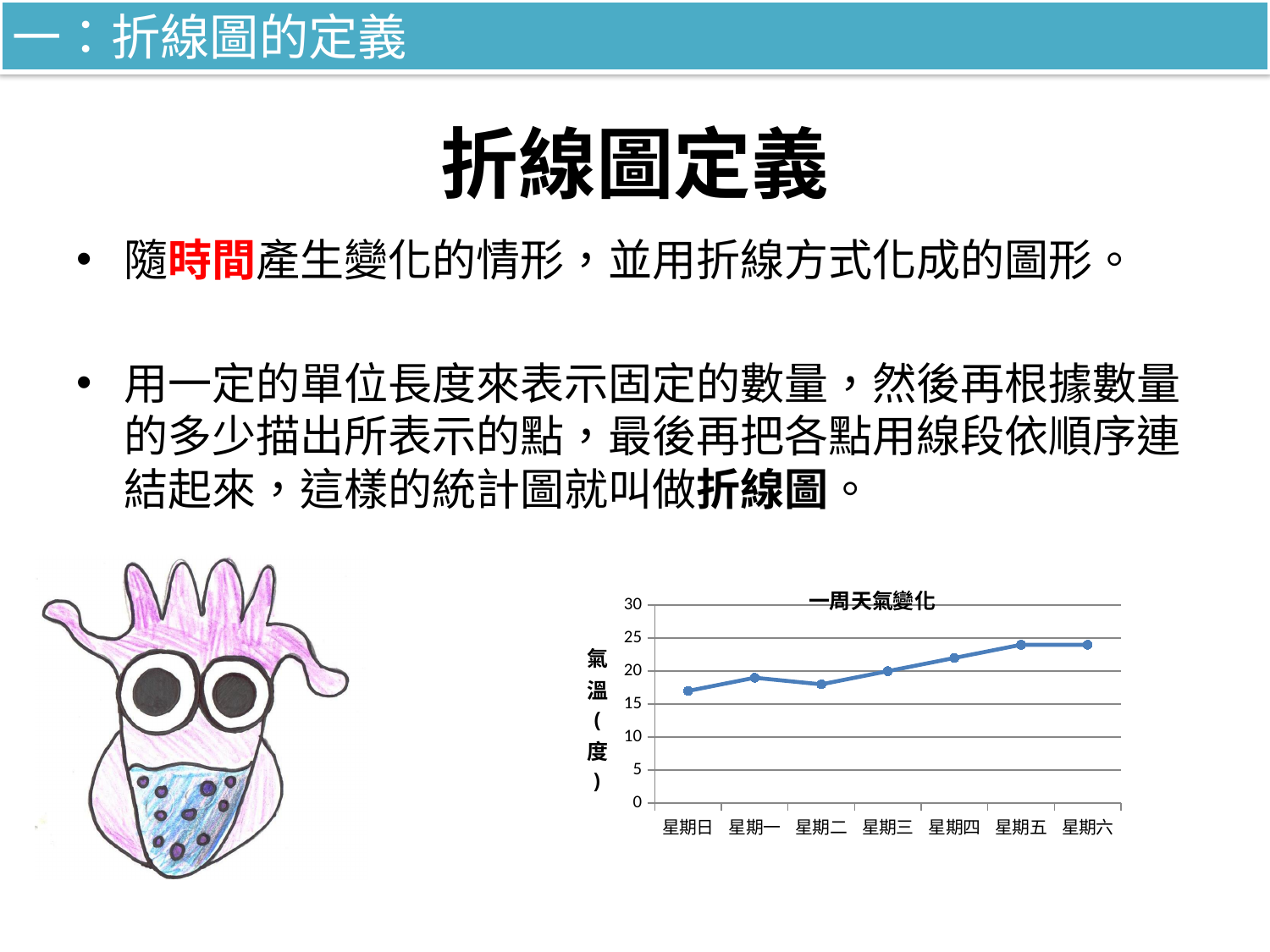
Which has the higher temperature, 星期五 or 星期日? 星期五 Overall, do the temperatures rise or fall from 星期日 to 星期六? rise Is the value for 星期四 greater or less than 20? greater What is the title of the chart on the slide? 一周天氣變化 Is the value for 星期日 greater or less than 20? less What is the label of the vertical axis of the chart? 氣溫(度) What kind of chart is shown on the slide? line chart Is the value for 星期五 greater or less than 20? greater Which has the higher temperature, 星期三 or 星期日? 星期三 How many days (data points) are plotted on the chart? 7